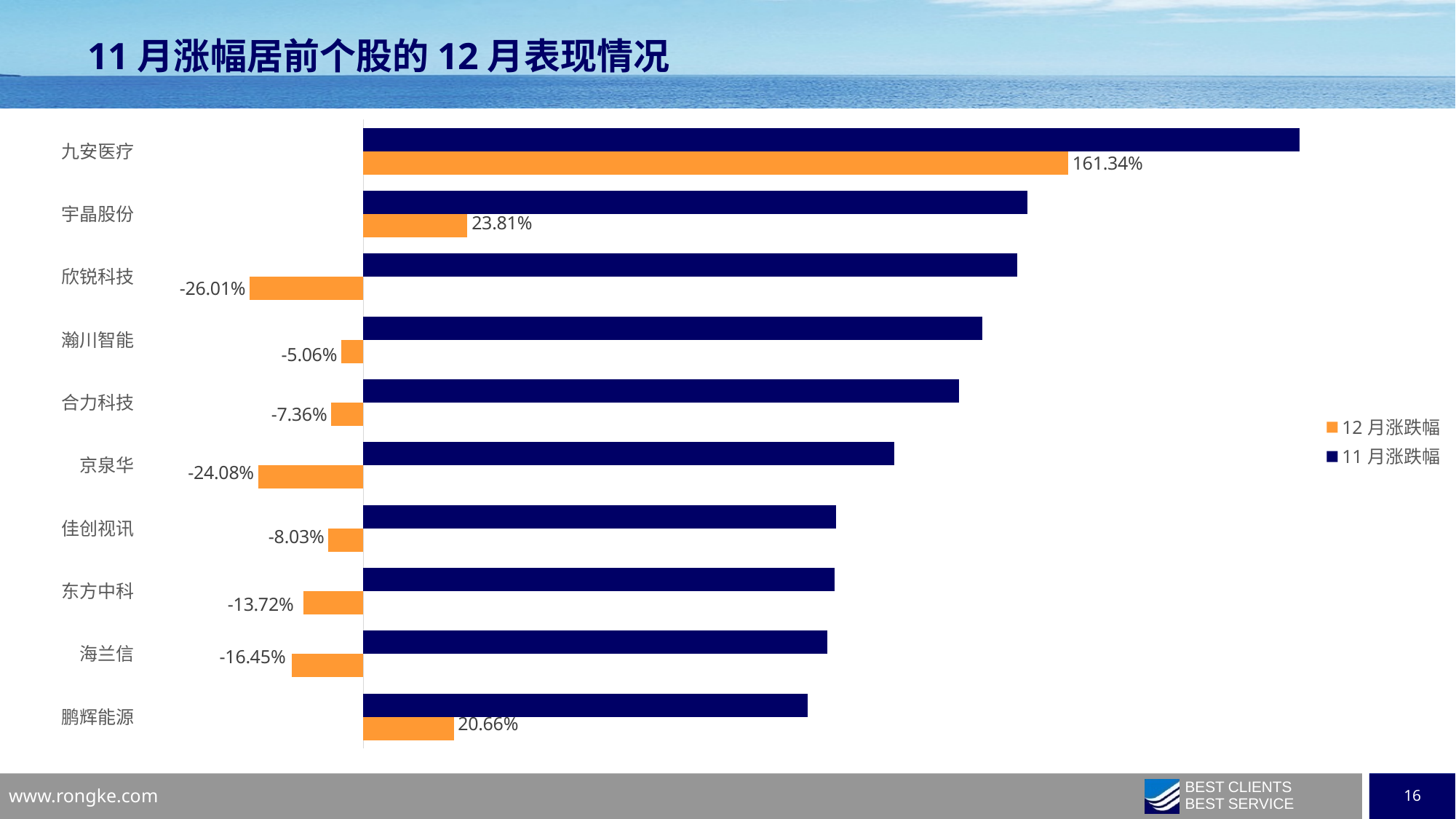
Which stock has the longest 11 月涨跌幅 bar? 九安医疗 What is the 12 月涨跌幅 value for 东方中科? -13.72% Which stock has the highest 12 月涨跌幅? 九安医疗 What is the 12 月涨跌幅 value for 欣锐科技? -26.01% How many series does the legend list? 2 What is the 12 月涨跌幅 value for 九安医疗? 161.34% What is the difference between the 12 月涨跌幅 of 宇晶股份 and 鹏辉能源? 3.15 percentage points What is the 12 月涨跌幅 value for 鹏辉能源? 20.66% Which has the larger 12 月涨跌幅, 京泉华 or 海兰信? 海兰信 Which stock has the shortest 11 月涨跌幅 bar? 鹏辉能源 Which stock has the lowest 12 月涨跌幅? 欣锐科技 How many stocks are shown in the chart? 10